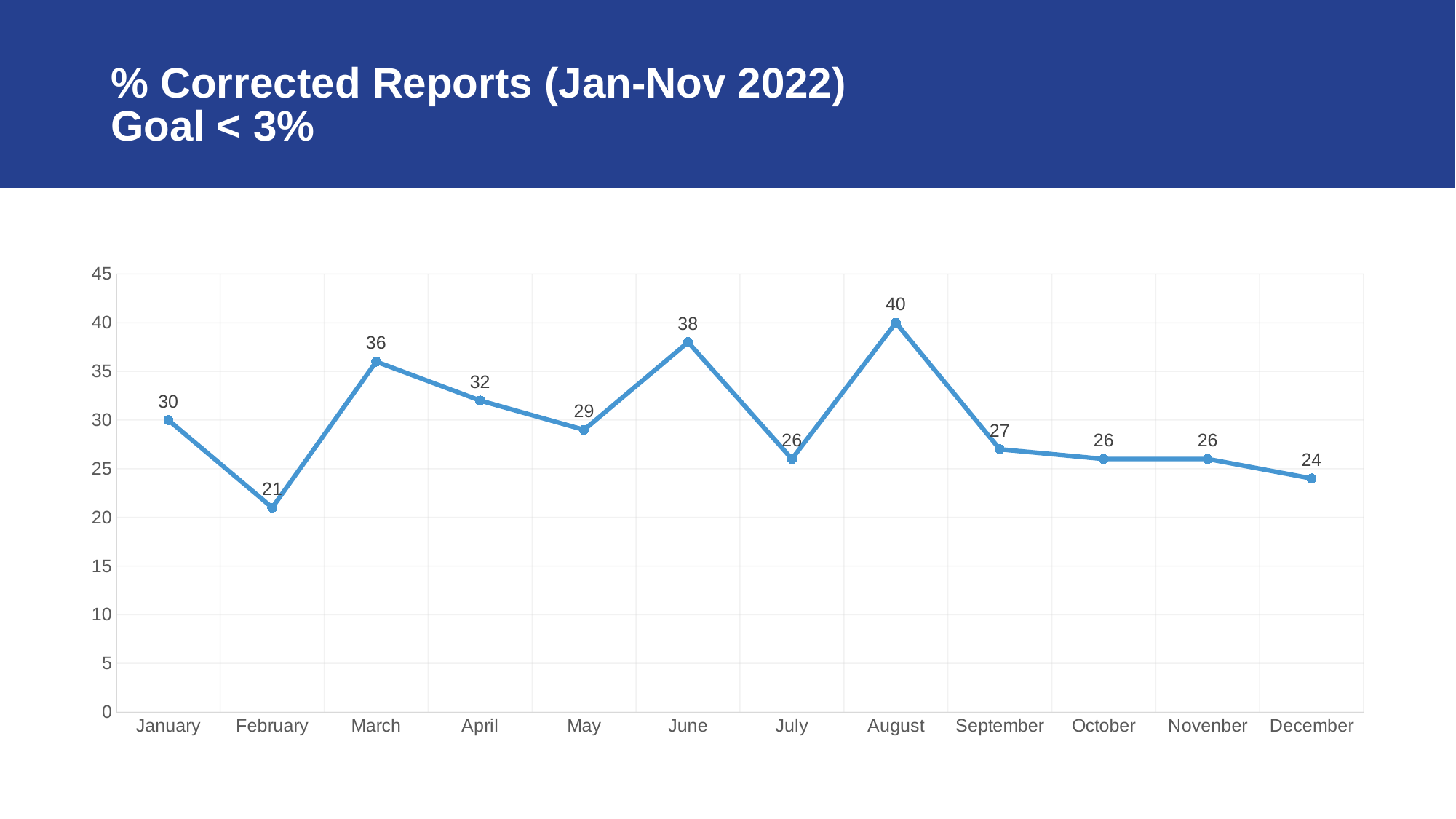
Is the value for January greater or less than 25? greater What is the value for August? 40 What is the value for December? 24 Which is larger, the value for March or the value for April? March How many months are plotted on the x axis? 12 What is the value for March? 36 What is the difference between the values for August and February? 19 Do the values rise or fall from September to December? fall Which month has the highest value? August Which month has the lowest value? February What is the difference between the values for June and July? 12 What kind of chart is shown on the slide? line chart